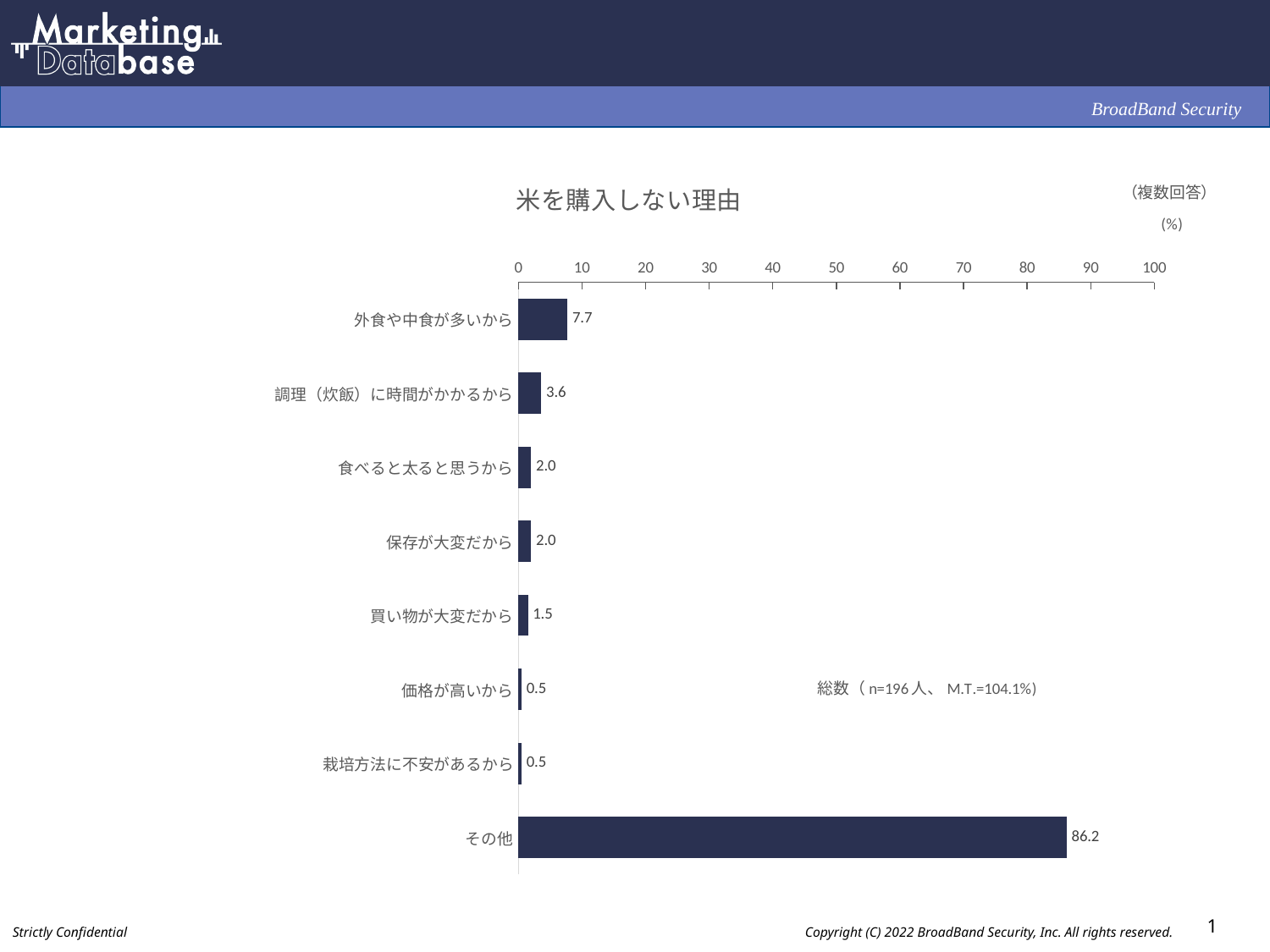
Which is larger, the value for 調理（炊飯）に時間がかかるから or the value for 買い物が大変だから? 調理（炊飯）に時間がかかるから What is the difference between the values for その他 and 外食や中食が多いから? 78.5 What is the difference between the values for 外食や中食が多いから and 調理（炊飯）に時間がかかるから? 4.1 What is the value for 調理（炊飯）に時間がかかるから? 3.6 Is the value for その他 greater or less than 80? greater What is the title of the chart? 米を購入しない理由 What kind of chart is shown on the slide? bar chart What is the value for 外食や中食が多いから? 7.7 What is the value for 買い物が大変だから? 1.5 How many categories are shown in the chart? 8 Which category has the highest value? その他 What is the value for その他? 86.2